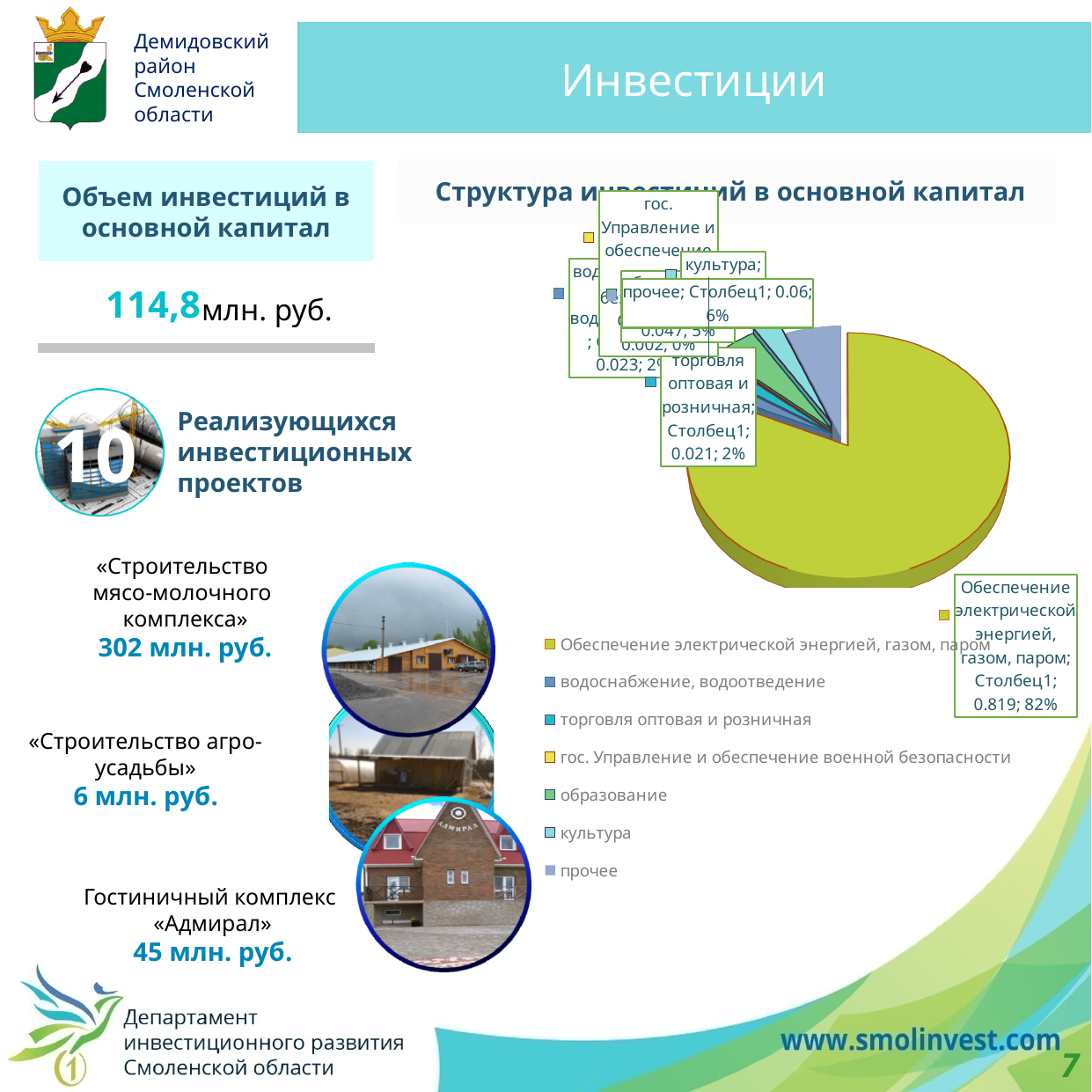
How many categories does the legend of the pie chart list? 7 What kind of chart is shown under the title "Структура инвестиций в основной капитал"? pie chart By how many percentage points does the share of "Обеспечение электрической энергией, газом, паром" exceed the share of "прочее"? 76% By how many percentage points does the share of "прочее" exceed the share of "торговля оптовая и розничная"? 4% What is the name of the data series shown in the pie chart's data labels? Столбец1 What share of the pie chart does "прочее" have? 6% What share of the pie chart does "торговля оптовая и розничная" have? 2% Which slice is larger in the pie chart: "прочее" or "торговля оптовая и розничная"? прочее Which category has the largest slice in the pie chart? Обеспечение электрической энергией, газом, паром What is the decimal value printed in the data label for "Обеспечение электрической энергией, газом, паром"? 0.819 What is the title of the pie chart on the slide? Структура инвестиций в основной капитал What share of the pie chart does "Обеспечение электрической энергией, газом, паром" have? 82%